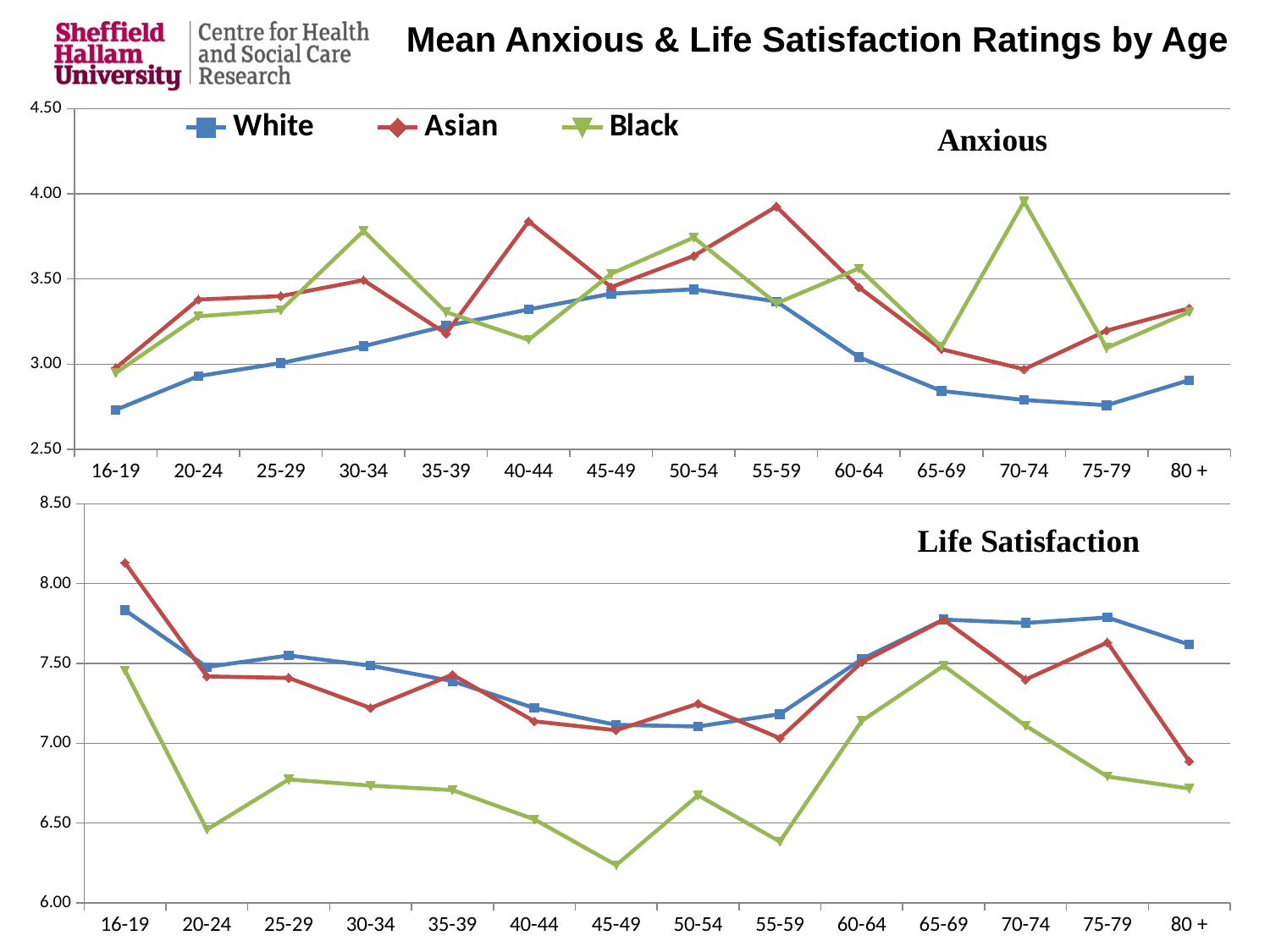
In the Life Satisfaction chart, does the Black line rise or fall from 16-19 to 20-24? fall Which series is shown in green in the legend? Black In the Life Satisfaction chart, which is larger at 80 +, White or Asian? White How many series does the legend list? 3 What kind of chart is the Anxious chart? line chart How many age categories are shown on the x axis of the Life Satisfaction chart? 14 In the Life Satisfaction chart, is the value for Asian at 16-19 greater or less than 8.00? greater In the Life Satisfaction chart, which age group has the lowest value for Black? 45-49 In the Anxious chart, is the value for Asian at 55-59 greater or less than 3.50? greater In the Anxious chart, is the value for White at 16-19 greater or less than 3.00? less In the Anxious chart, which age group has the highest value for Black? 70-74 In the Anxious chart, which age group has the lowest value for White? 16-19